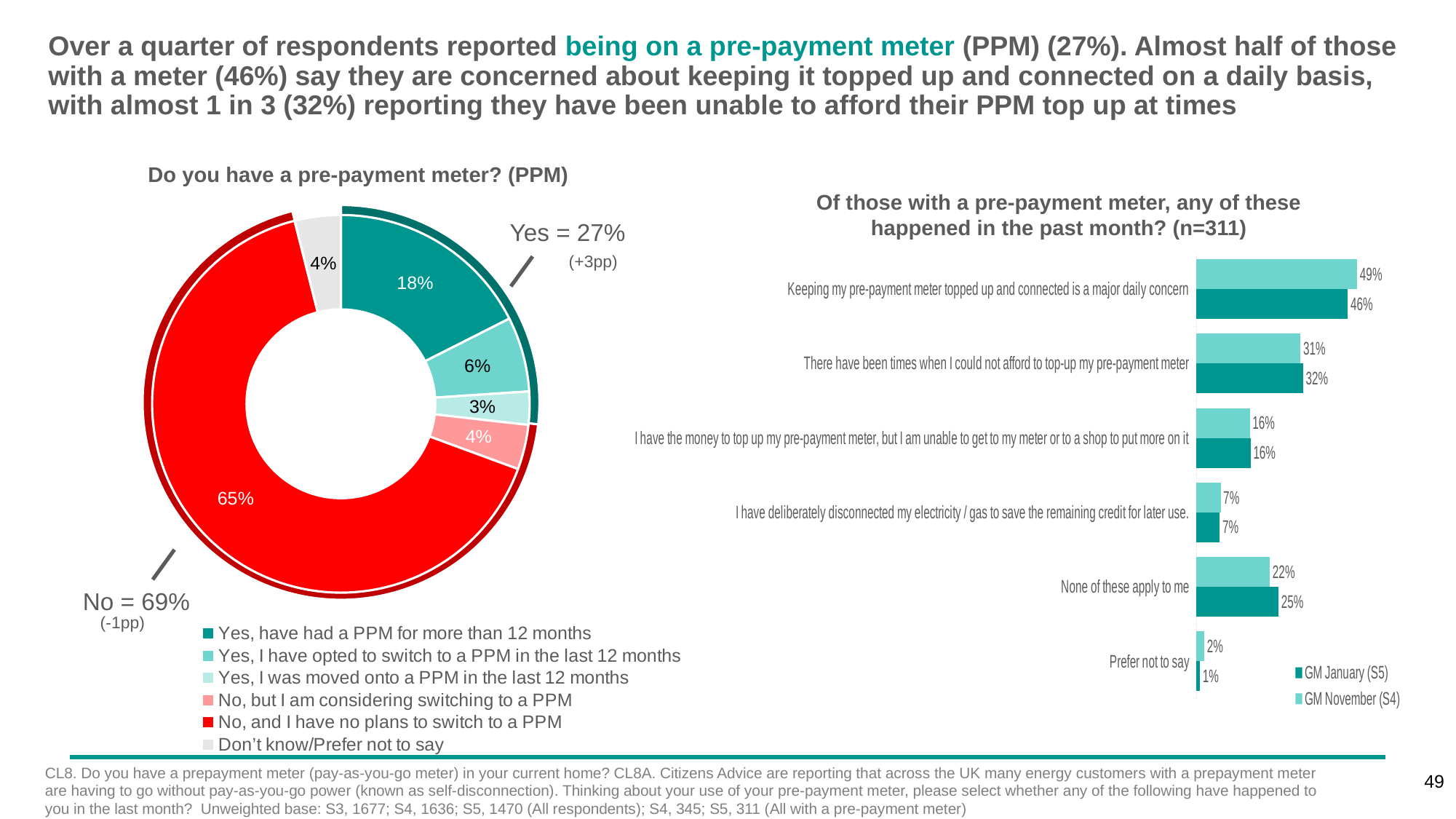
In the chart 'Do you have a pre-payment meter? (PPM)', what share of respondents said 'No, and I have no plans to switch to a PPM'? 65% In the chart 'Of those with a pre-payment meter, any of these happened in the past month?', which category has the lowest GM January (S5) value? Prefer not to say In the chart 'Do you have a pre-payment meter? (PPM)', what share of respondents said 'Yes, have had a PPM for more than 12 months'? 18% In the chart 'Of those with a pre-payment meter, any of these happened in the past month?', what is the difference between the GM November (S4) and GM January (S5) values for 'Keeping my pre-payment meter topped up and connected is a major daily concern'? 3 percentage points In the chart 'Of those with a pre-payment meter, any of these happened in the past month?', what is the GM November (S4) value for 'None of these apply to me'? 22% In the chart 'Of those with a pre-payment meter, any of these happened in the past month?', how many series does the legend list? 2 In the chart 'Of those with a pre-payment meter, any of these happened in the past month?', which statement has the highest GM January (S5) value? Keeping my pre-payment meter topped up and connected is a major daily concern In the chart 'Of those with a pre-payment meter, any of these happened in the past month?', what is the GM January (S5) value for 'Keeping my pre-payment meter topped up and connected is a major daily concern'? 46% In the chart 'Do you have a pre-payment meter? (PPM)', what is the combined 'Yes' share shown on the chart? 27% What kind of chart is 'Do you have a pre-payment meter? (PPM)'? Pie (donut) chart In the chart 'Do you have a pre-payment meter? (PPM)', how many categories does the legend list? 6 What kind of chart is 'Of those with a pre-payment meter, any of these happened in the past month?'? Bar chart